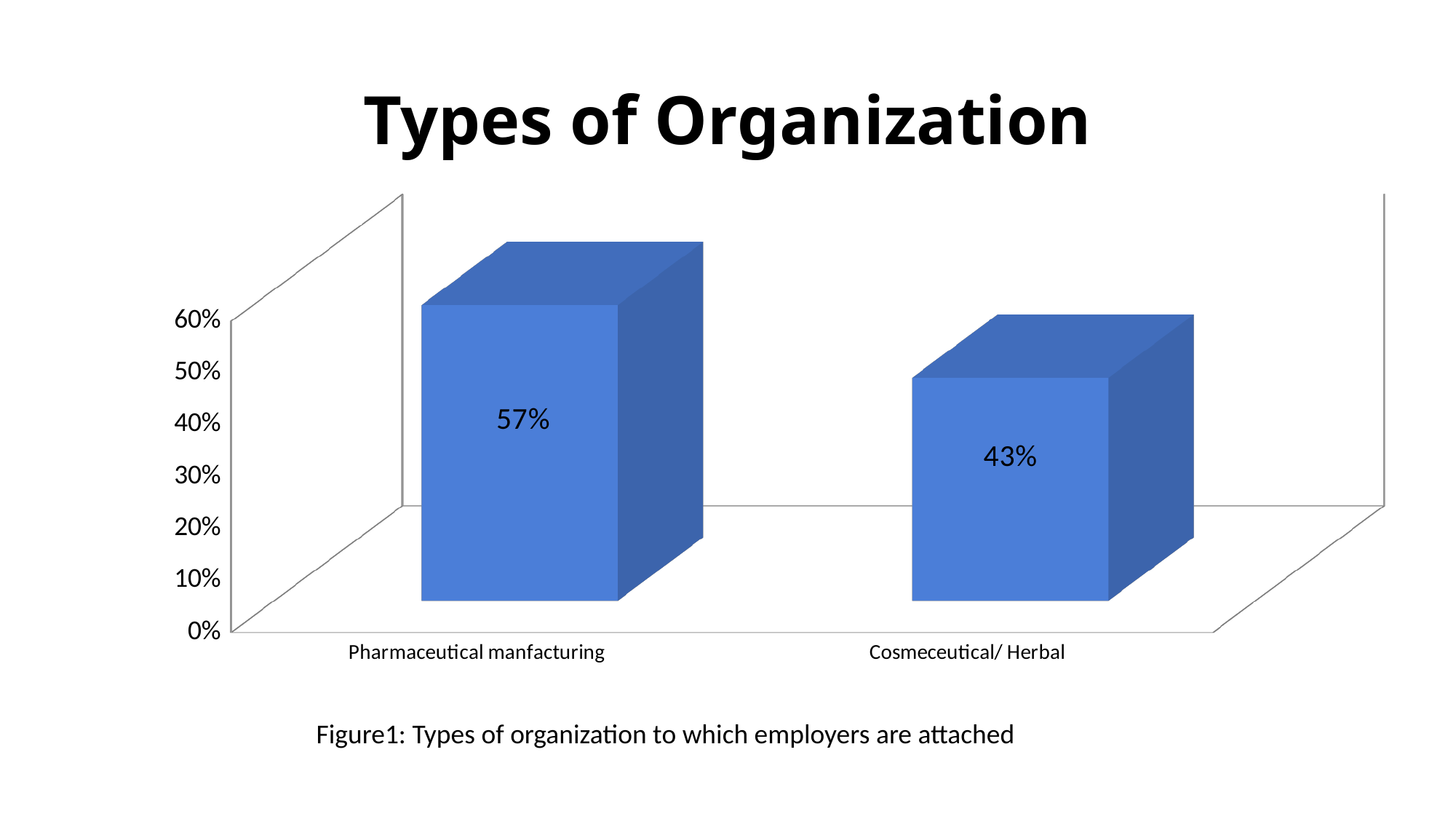
Is the value for Cosmeceutical/ Herbal greater or less than 50%? less How many categories are shown in the chart? 2 Is the value for Pharmaceutical manfacturing greater or less than 50%? greater What is the value for Cosmeceutical/ Herbal? 43% What is the highest value shown on the vertical axis? 60% Which is larger, the value for Pharmaceutical manfacturing or the value for Cosmeceutical/ Herbal? Pharmaceutical manfacturing What kind of chart is shown on the slide? Bar chart What is the title of the chart? Types of Organization What is the value for Pharmaceutical manfacturing? 57% Which category has the lowest value? Cosmeceutical/ Herbal What is the difference between the values for Pharmaceutical manfacturing and Cosmeceutical/ Herbal? 14% Which category has the highest value? Pharmaceutical manfacturing